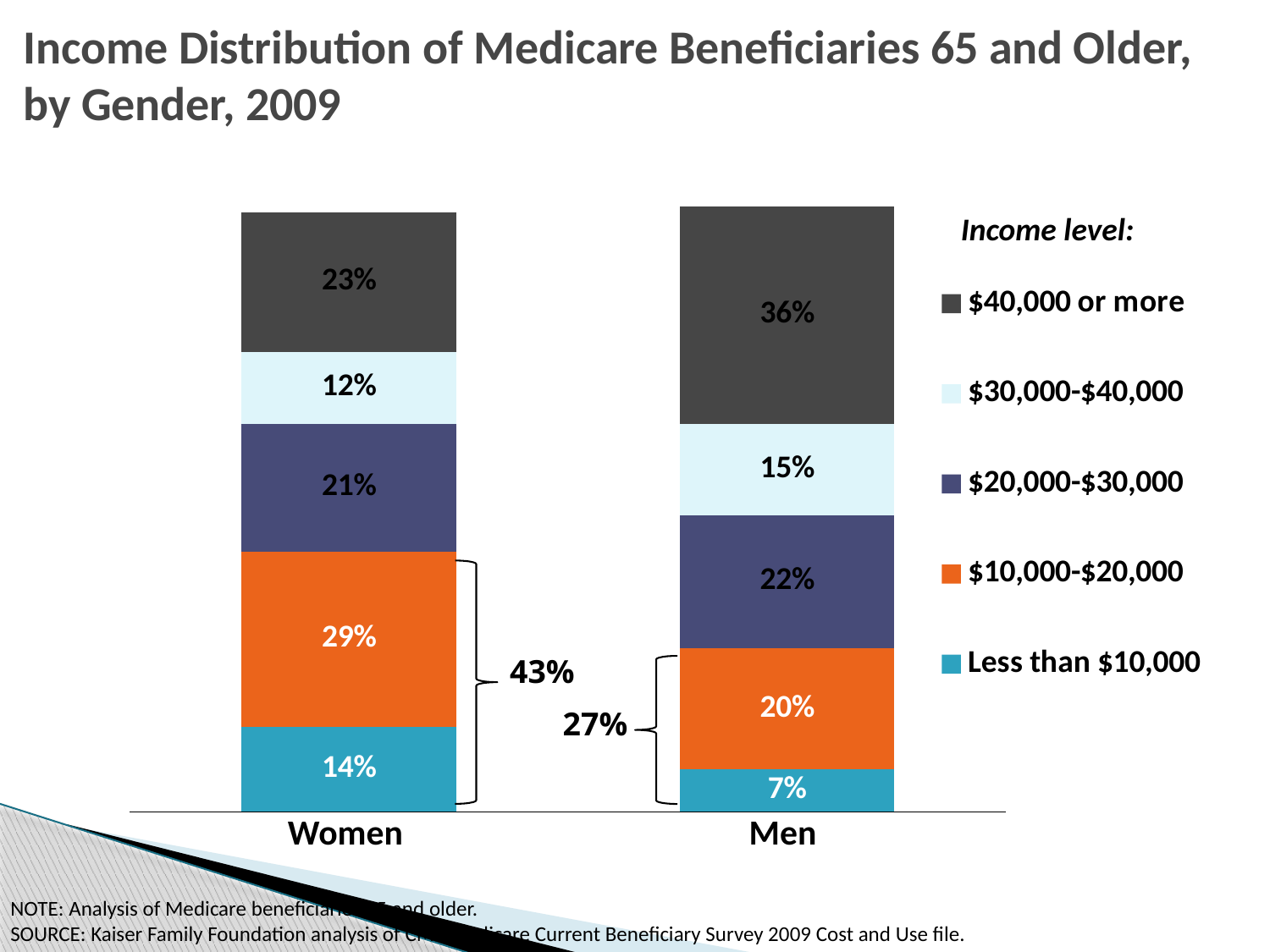
Which gender has the larger share with income of $40,000 or more? Men How many categories are shown on the x axis? 2 What is the value for women in the $10,000-$20,000 income level? 29% What kind of chart is shown on the slide? Stacked bar chart What is the difference between the $40,000 or more share for men and for women? 13 percentage points What is the combined share of women with income below $20,000, as labelled by the bracket? 43% What share of women have income of $40,000 or more? 23% Which income level is the largest segment in the Men bar? $40,000 or more What share of men have income of less than $10,000? 7% What is the value for men in the $20,000-$30,000 income level? 22% What is the combined share of men with income below $20,000, as labelled by the bracket? 27% How many series does the legend list? 5